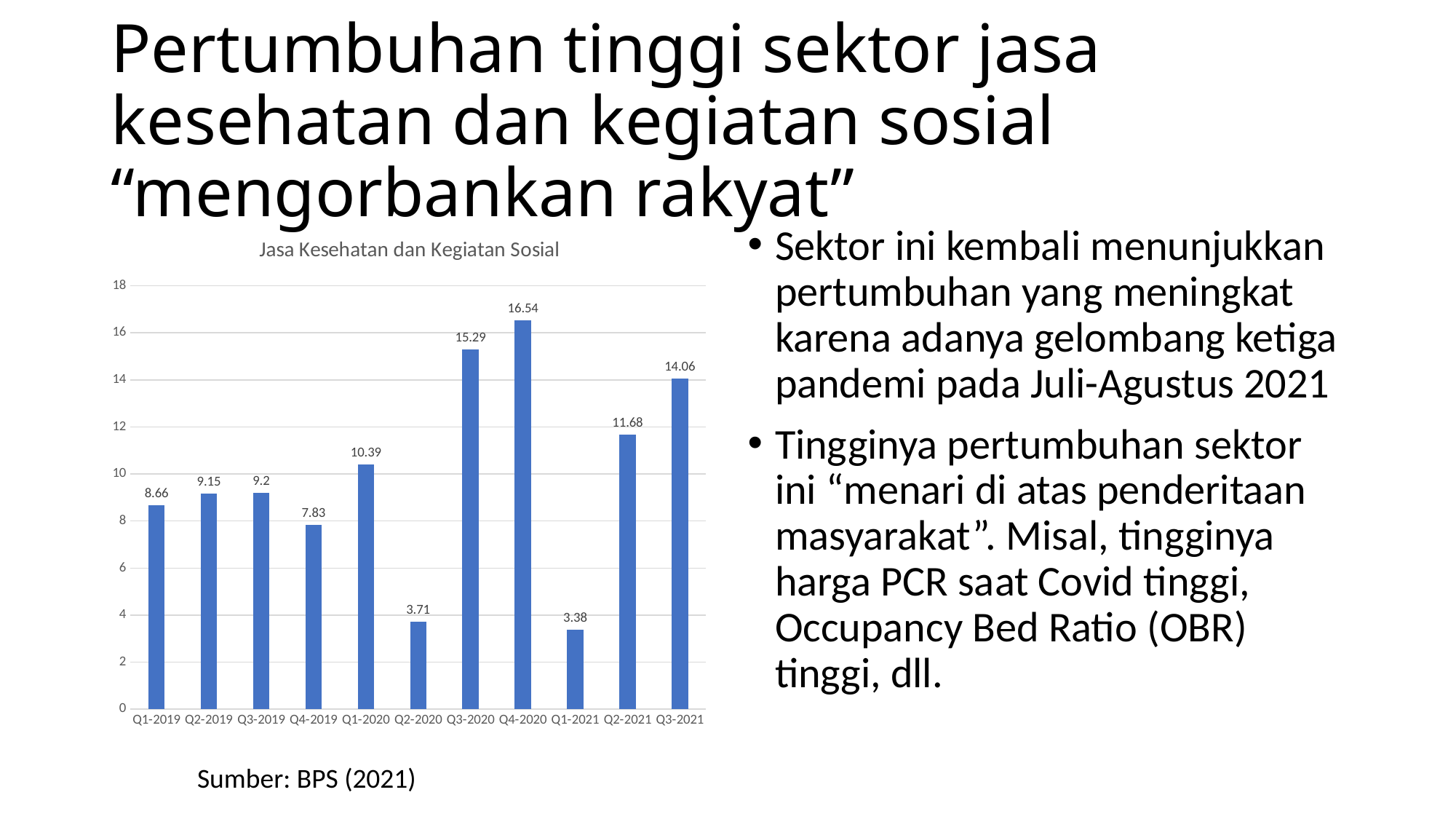
What kind of chart is shown on the slide? Bar chart What is the title of the chart? Jasa Kesehatan dan Kegiatan Sosial What is the difference between the values for Q3-2021 and Q2-2021? 2.38 What is the value for Q3-2021? 14.06 Which is larger, the value for Q1-2020 or the value for Q4-2019? Q1-2020 What is the value for Q2-2020? 3.71 Which quarter has the highest value? Q4-2020 What is the value for Q4-2020? 16.54 Is the value for Q2-2021 greater or less than 10? greater Which quarter has the lowest value? Q1-2021 How many quarters are shown on the x axis? 11 What is the difference between the values for Q4-2020 and Q3-2020? 1.25